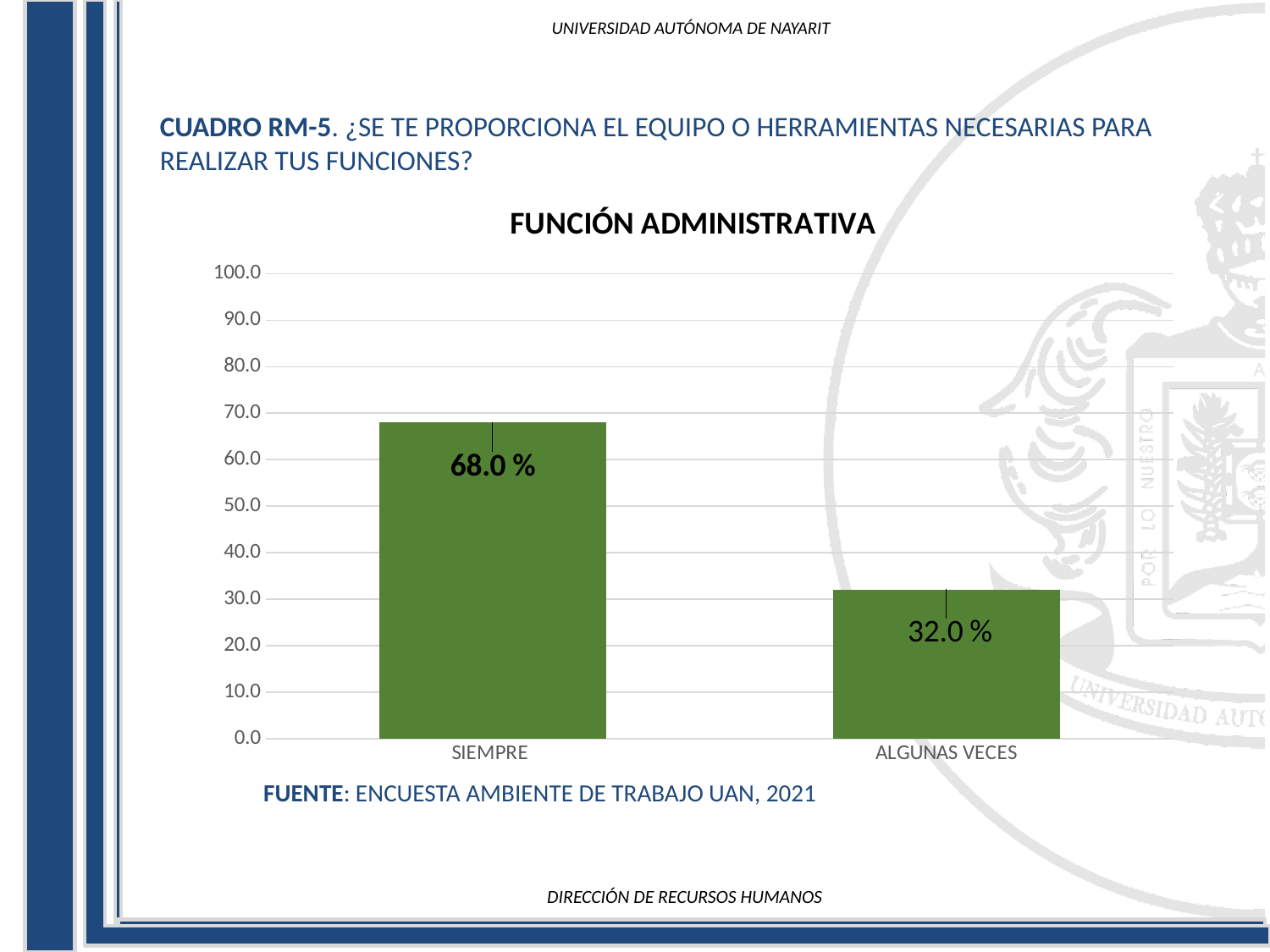
What is the difference between the values for SIEMPRE and ALGUNAS VECES? 36.0 % What is the value for SIEMPRE? 68.0 % Is the value for ALGUNAS VECES greater or less than 40.0? less What kind of chart is shown on the slide? bar chart What is the value for ALGUNAS VECES? 32.0 % How many categories are shown on the x axis? 2 Is the value for SIEMPRE greater or less than 60.0? greater Which is larger, the value for SIEMPRE or the value for ALGUNAS VECES? SIEMPRE Which category has the highest value? SIEMPRE Which category has the lowest value? ALGUNAS VECES What is the highest value shown on the y axis? 100.0 What is the title of the chart? FUNCIÓN ADMINISTRATIVA